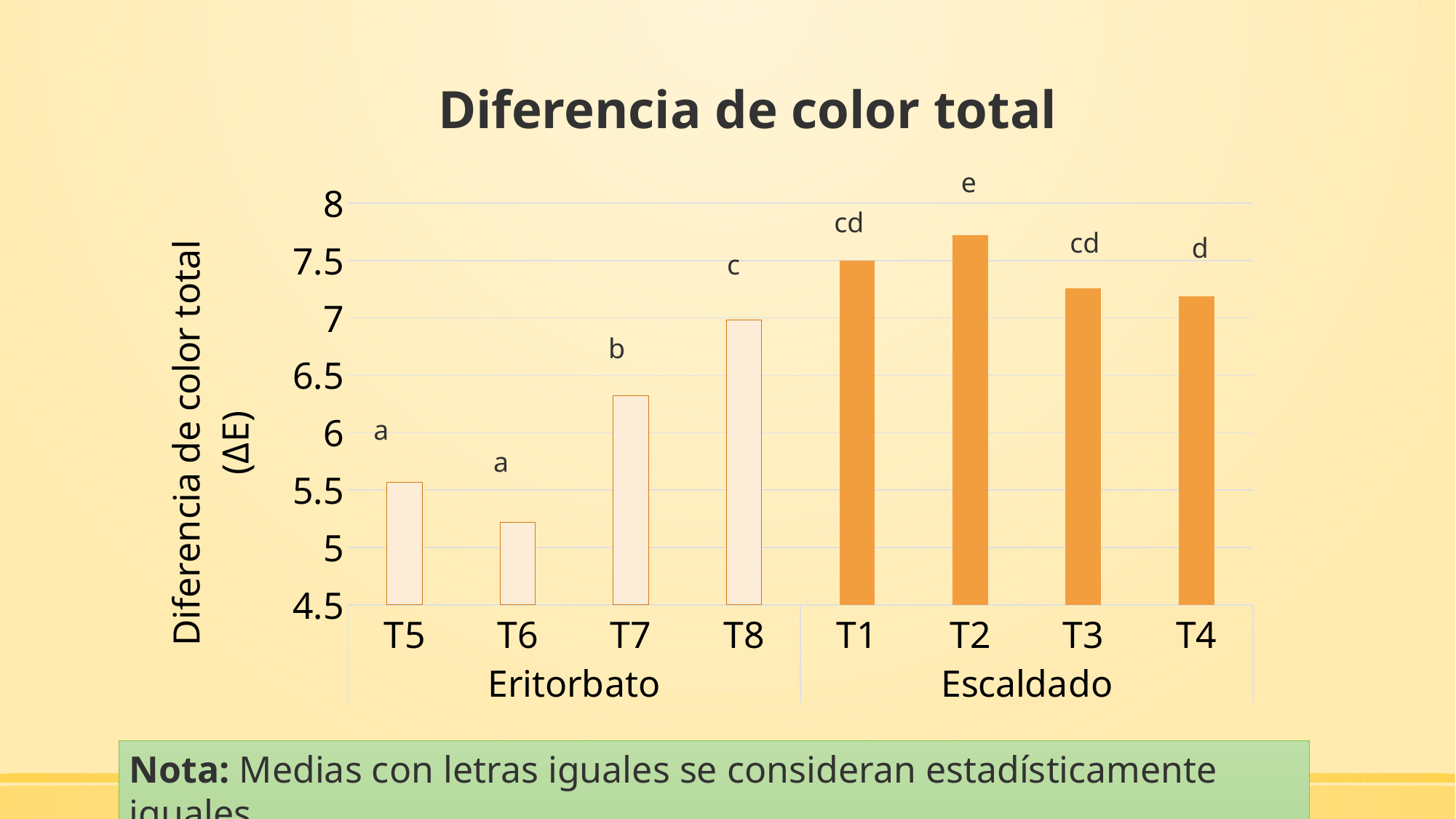
Which treatment has the lowest total colour difference? T6 Is the value for T4 greater or less than 7? greater Is the value for T6 greater or less than 5.5? less What statistical letter is shown above the T2 bar? e What kind of chart is shown on the slide? Bar chart Which has a larger value, T1 or T3? T1 Is the value for T2 greater or less than 7.5? greater What is the title of the chart? Diferencia de color total How many bars (treatments) are plotted in the chart? 8 Which treatment has the highest total colour difference? T2